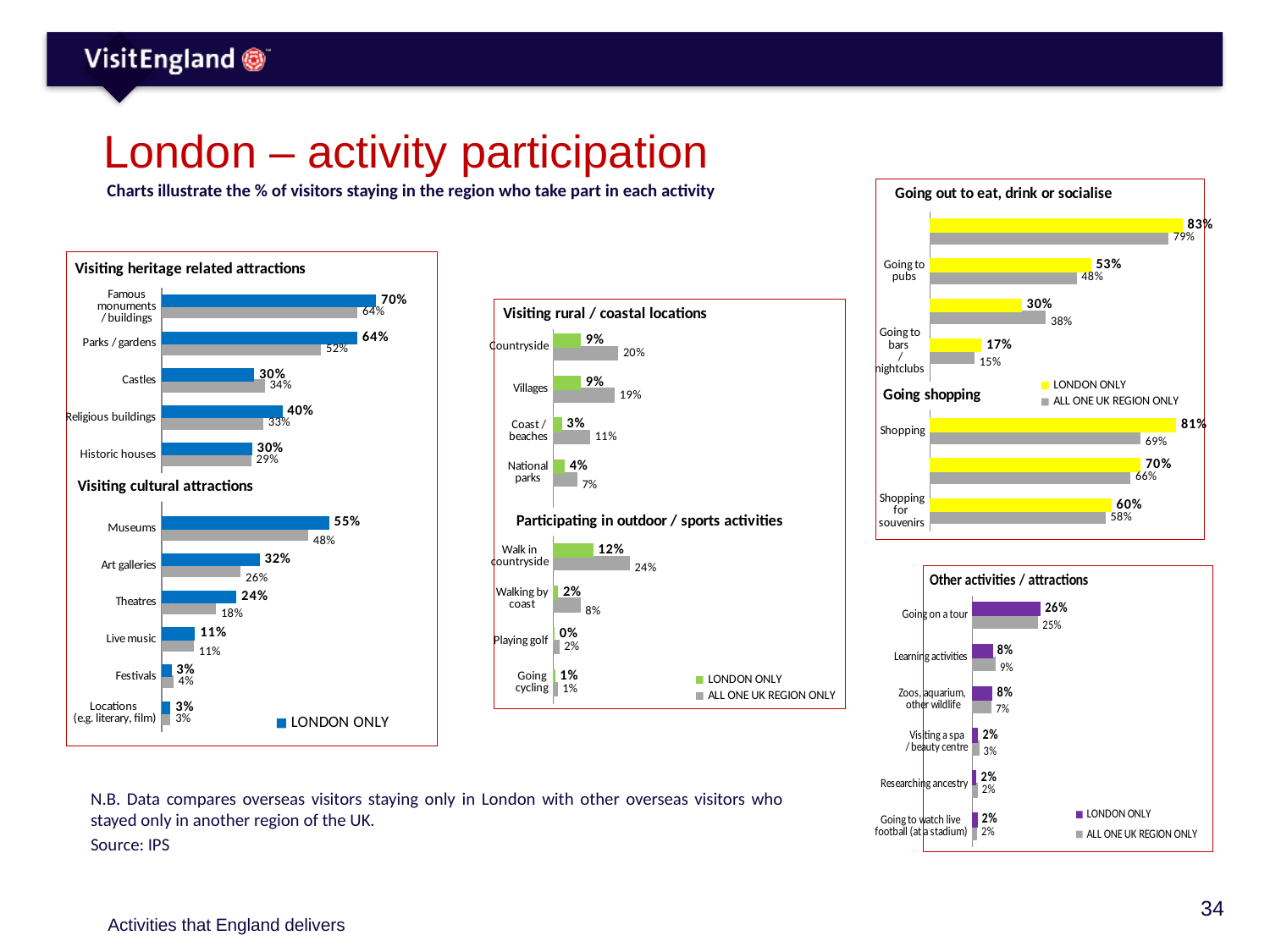
In the 'Visiting cultural attractions' chart, which category has the highest LONDON ONLY value? Museums What type of chart is the 'Other activities / attractions' chart? Bar chart In the 'Visiting rural / coastal locations' chart, what is the ALL ONE UK REGION ONLY value for Countryside? 20% In the 'Participating in outdoor / sports activities' chart, how many categories are shown? 4 In the 'Other activities / attractions' chart, what is the ALL ONE UK REGION ONLY value for Learning activities? 9% In the 'Visiting rural / coastal locations' chart, which category has the lowest LONDON ONLY value? Coast / beaches In the 'Visiting cultural attractions' chart, what is the difference between the LONDON ONLY and ALL ONE UK REGION ONLY values for Theatres? 6% In the 'Visiting heritage related attractions' chart, what is the LONDON ONLY value for Famous monuments / buildings? 70% In the 'Visiting heritage related attractions' chart, what is the ALL ONE UK REGION ONLY value for Parks / gardens? 52% In the 'Going shopping' chart, which is larger for Shopping: the LONDON ONLY value or the ALL ONE UK REGION ONLY value? LONDON ONLY In the 'Participating in outdoor / sports activities' chart, what is the LONDON ONLY value for Walk in countryside? 12% In the 'Going out to eat, drink or socialise' chart, what is the LONDON ONLY value for Going to pubs? 53%